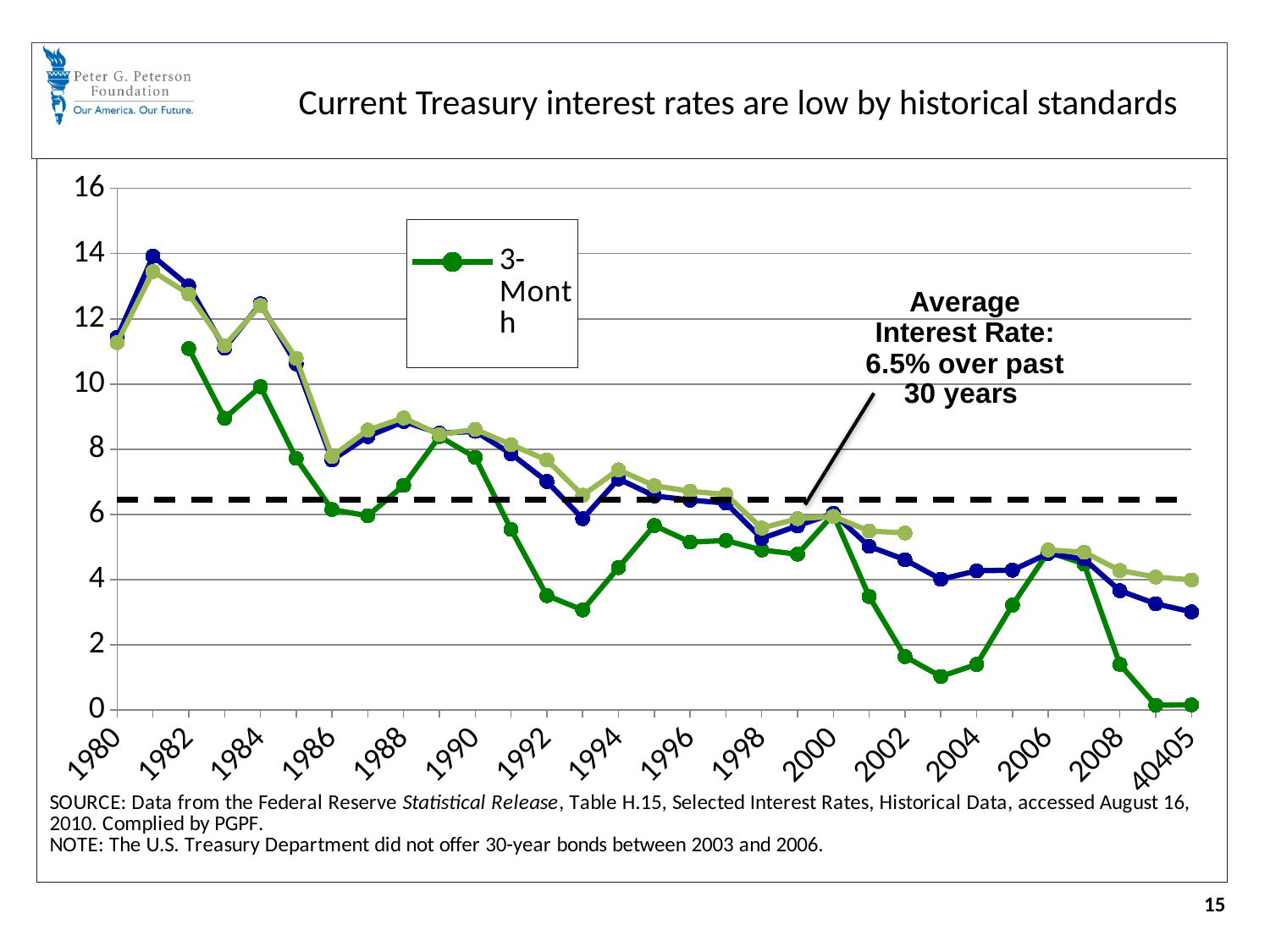
Is the value of the 3-Month series in 1992 greater or less than 4? less What does the horizontal dashed line on the chart represent? Average Interest Rate: 6.5% over past 30 years Overall, does the 3-Month series rise or fall from 1980 to the end of the chart? fall What kind of chart is shown on the slide? line chart Is the highest value reached by the 3-Month series greater or less than 12? less Which is larger for the 3-Month series, the value in 1982 or the value in 1992? 1982 Is the value of the 3-Month series in 1996 greater or less than 4? greater Which is larger for the 3-Month series, the value in 2006 or the value in 2008? 2006 What is the title of the slide's chart? Current Treasury interest rates are low by historical standards